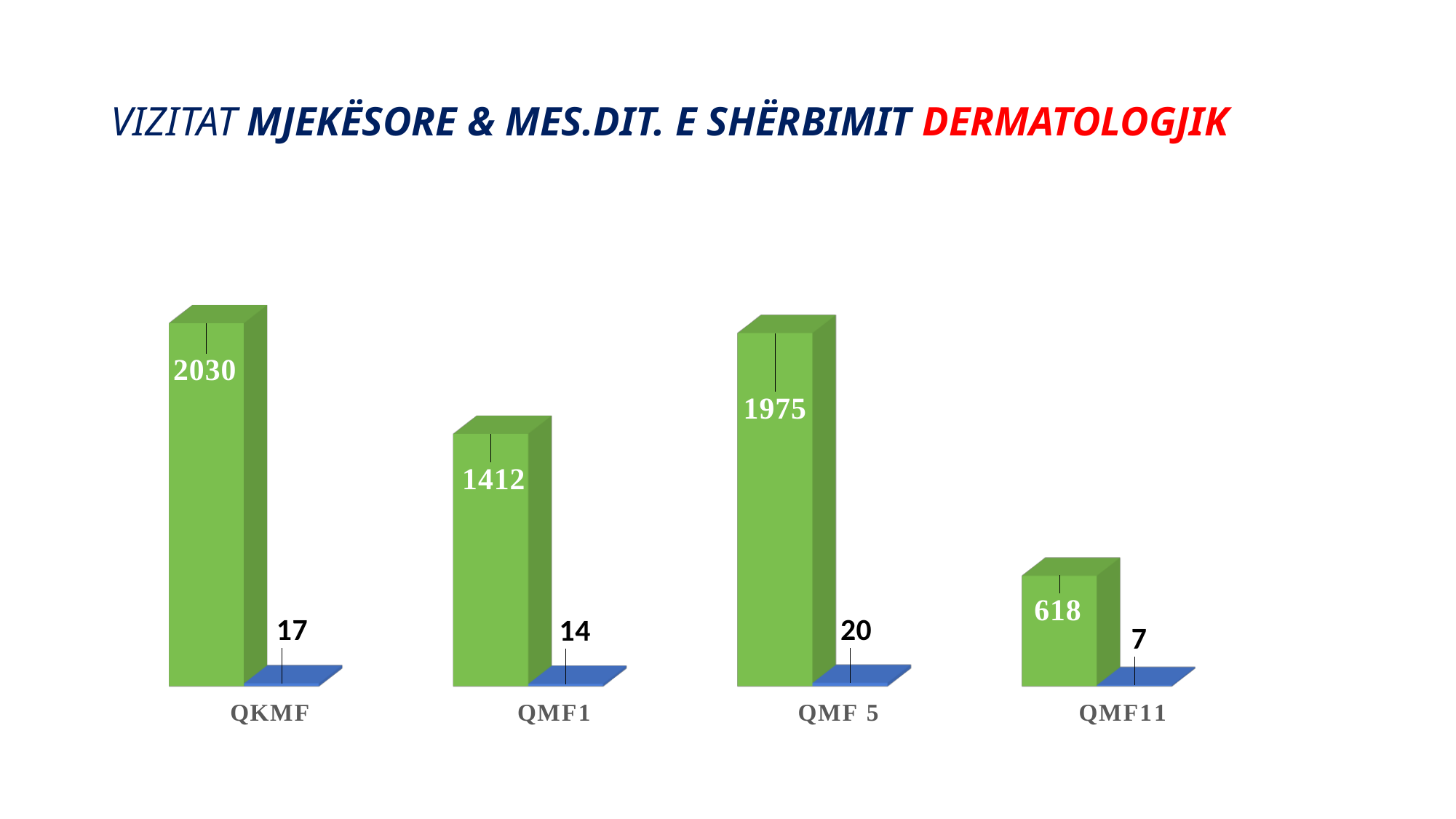
What is the value of the blue bar for QMF1? 14 What is the value of the green bar for QMF11? 618 What is the difference between the blue bar values for QMF 5 and QMF11? 13 Which category has the highest green bar? QKMF How many categories are shown on the x axis? 4 What kind of chart is shown on the slide? Bar chart Which has a larger green bar value, QMF1 or QMF 5? QMF 5 What is the title of the slide? VIZITAT MJEKËSORE & MES.DIT. E SHËRBIMIT DERMATOLOGJIK What is the difference between the green bar values for QKMF and QMF1? 618 Which category has the lowest blue bar? QMF11 What is the value of the green bar for QKMF? 2030 What is the value of the blue bar for QMF 5? 20